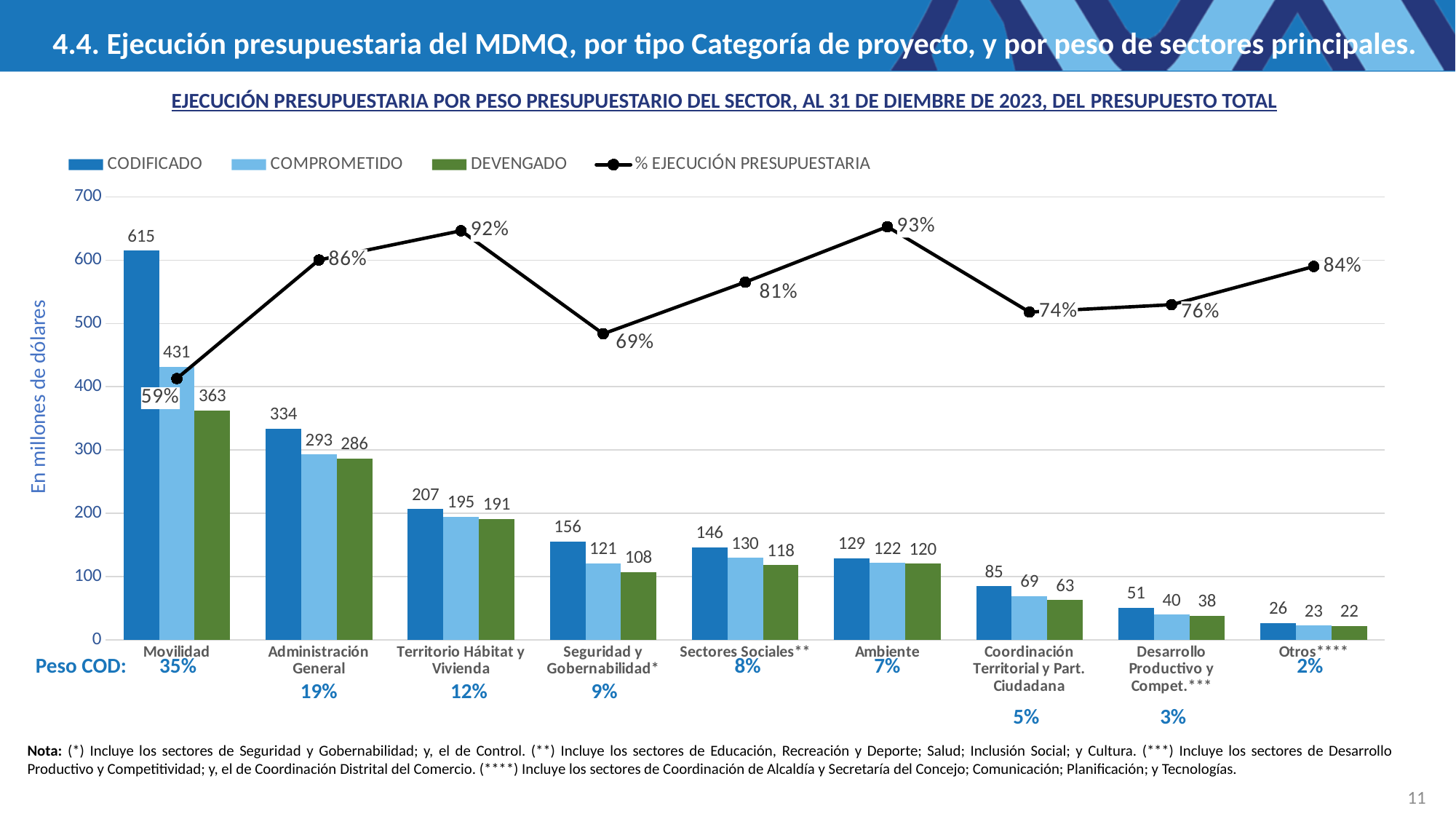
Do the CODIFICADO values rise or fall from left to right along the x axis? Fall Which category has the lowest % EJECUCIÓN PRESUPUESTARIA? Movilidad Which category has the highest CODIFICADO value? Movilidad What is the difference between the CODIFICADO and DEVENGADO values for Movilidad? 252 Which is larger, the DEVENGADO value for Sectores Sociales** or for Ambiente? Ambiente What is the COMPROMETIDO value for Seguridad y Gobernabilidad*? 121 What is the CODIFICADO value for Movilidad? 615 How many categories are shown on the x axis? 9 How many series does the legend list? 4 What is the % EJECUCIÓN PRESUPUESTARIA for Ambiente? 93% What kind of chart is this? Combined bar and line chart What is the DEVENGADO value for Administración General? 286